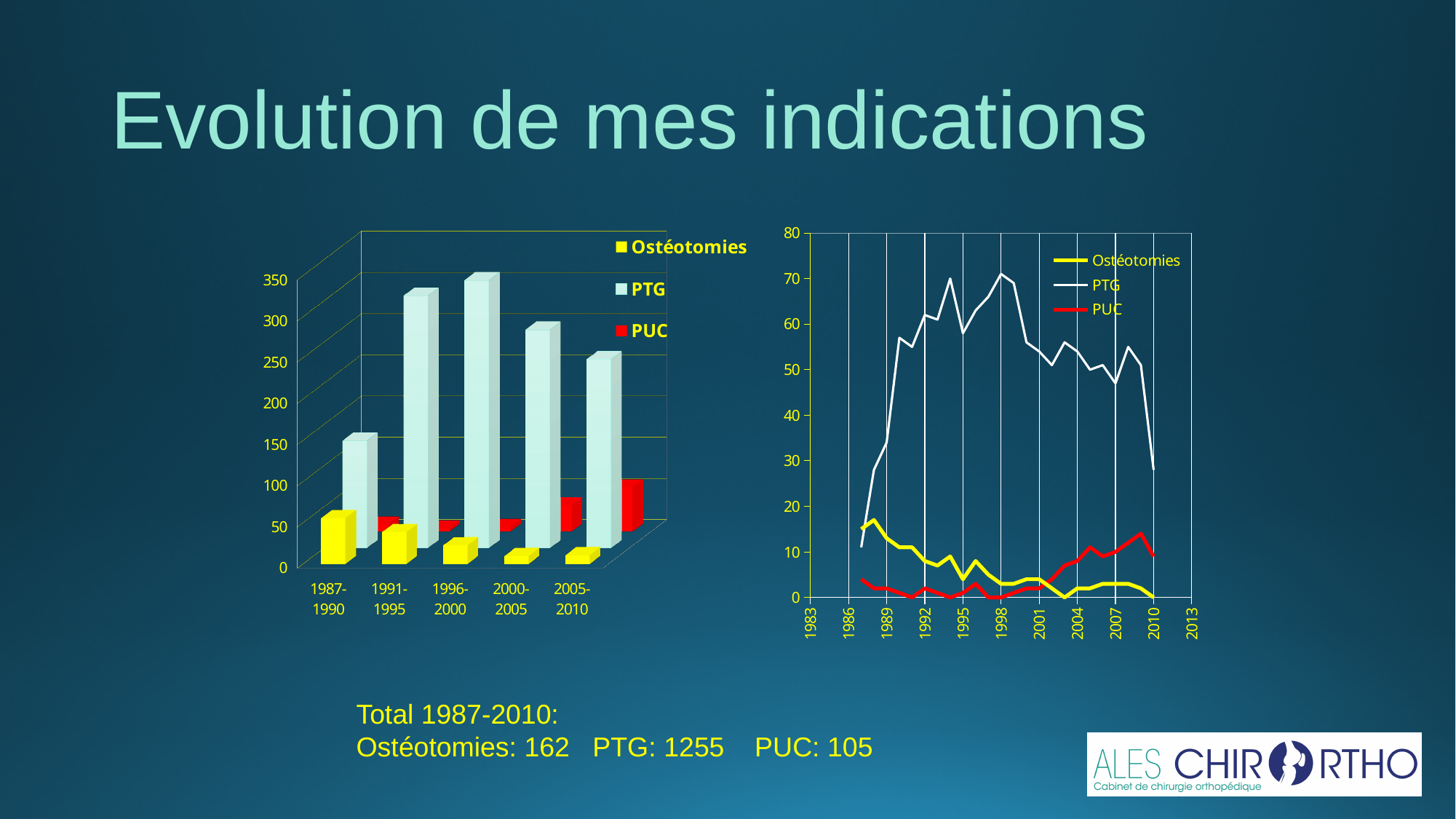
In the left bar chart, is the PTG value for 1996-2000 greater or less than 300? greater In the left bar chart, which is larger for 2005-2010, the PUC bar or the Ostéotomies bar? PUC In the left bar chart, which period has the highest PUC bar? 2005-2010 What kind of chart is the chart on the right of the slide? line chart How many series does the legend of the left bar chart list? 3 In the left bar chart, is the PTG value for 1987-1990 greater or less than 200? less In the right line chart, does the Ostéotomies line generally rise or fall from 1987 to 2010? fall In the left bar chart, which period has the highest Ostéotomies bar? 1987-1990 In the right line chart, is the PTG value for 1987 greater or less than 20? less How many time periods are shown on the x axis of the left bar chart? 5 In the left bar chart, which period has the highest PTG bar? 1996-2000 What kind of chart is the chart on the left of the slide? bar chart